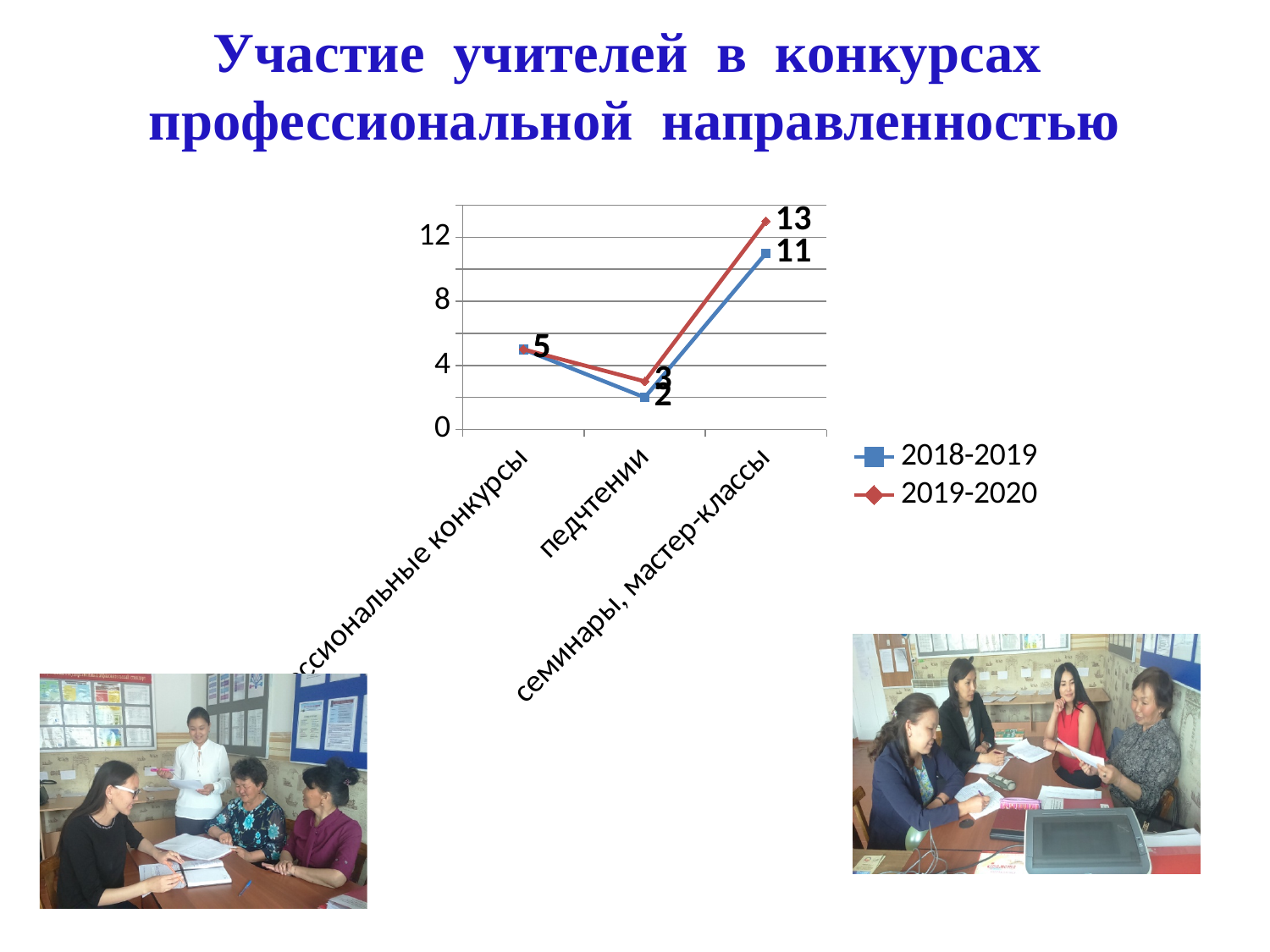
At педчтении, what is the difference between the 2019-2020 value and the 2018-2019 value? 1 How many categories are shown on the x axis? 3 What is the value for the 2019-2020 series at педчтении? 3 What is the value for the 2018-2019 series at семинары, мастер-классы? 11 At семинары, мастер-классы, what is the difference between the 2019-2020 value and the 2018-2019 value? 2 What kind of chart is shown on the slide? line chart At семинары, мастер-классы, which series has the larger value, 2018-2019 or 2019-2020? 2019-2020 For the 2018-2019 series, which category has the lowest value? педчтении How many series does the legend list? 2 What is the value for the 2019-2020 series at семинары, мастер-классы? 13 For the 2019-2020 series, which category has the highest value? семинары, мастер-классы What is the value for the 2018-2019 series at педчтении? 2